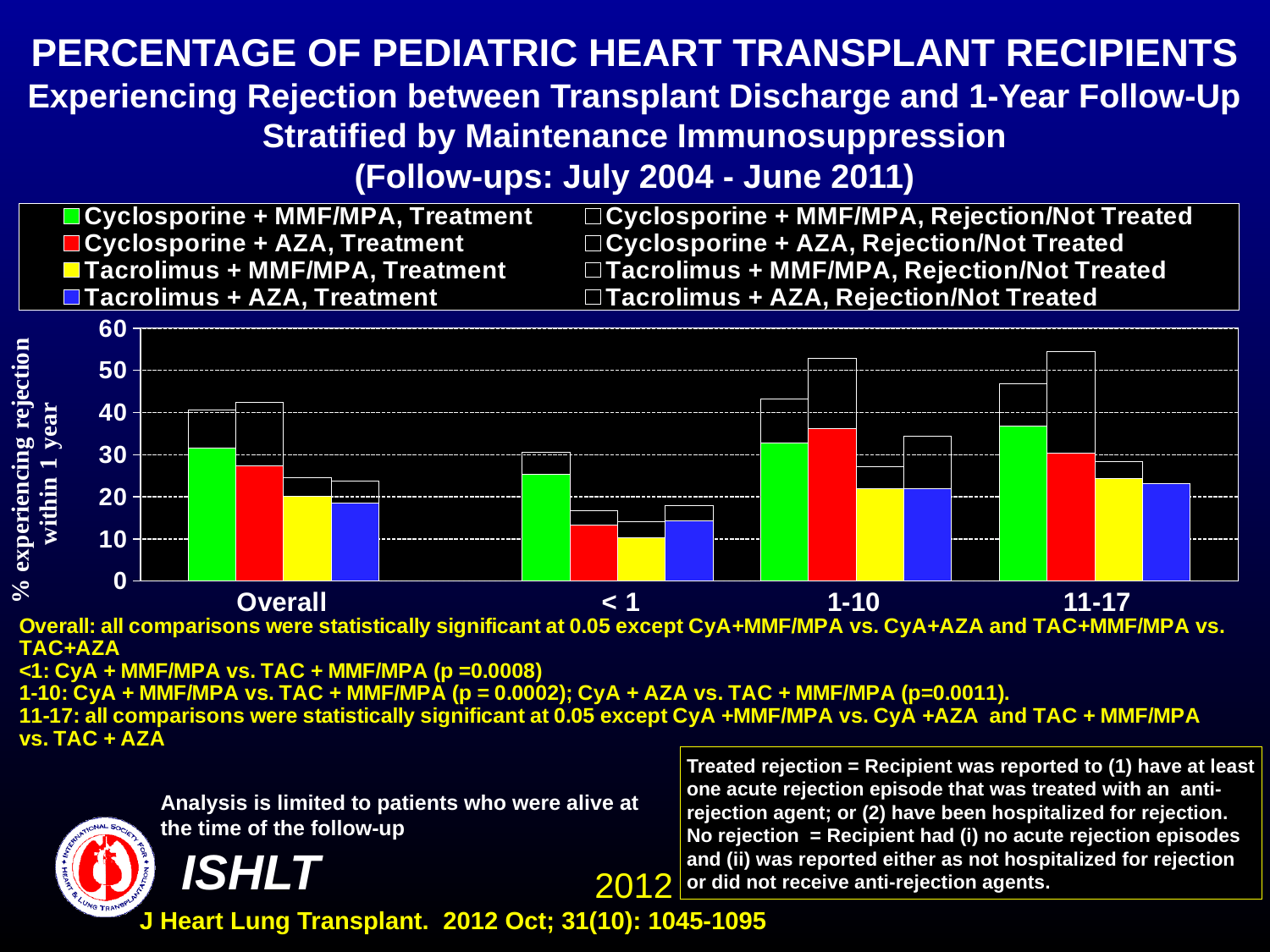
In the 1-10 category, is the Cyclosporine + AZA, Treatment value greater or less than 30? greater In the < 1 category, which is larger: the Tacrolimus + AZA, Treatment value or the Tacrolimus + MMF/MPA, Treatment value? Tacrolimus + AZA, Treatment In the 11-17 category, which immunosuppression regimen has the highest Treatment value? Cyclosporine + MMF/MPA What is the label on the y axis of the chart? % experiencing rejection within 1 year How many series does the chart legend list? 8 In the Overall category, is the Tacrolimus + AZA, Treatment value greater or less than 20? less How many age categories are shown along the x axis of the chart? 4 What follow-up period is given in the chart title? July 2004 - June 2011 In the < 1 category, which immunosuppression regimen has the highest Treatment value? Cyclosporine + MMF/MPA What kind of chart is shown on the slide? Stacked bar chart In the 11-17 category, is the Cyclosporine + MMF/MPA, Treatment value greater or less than 30? greater